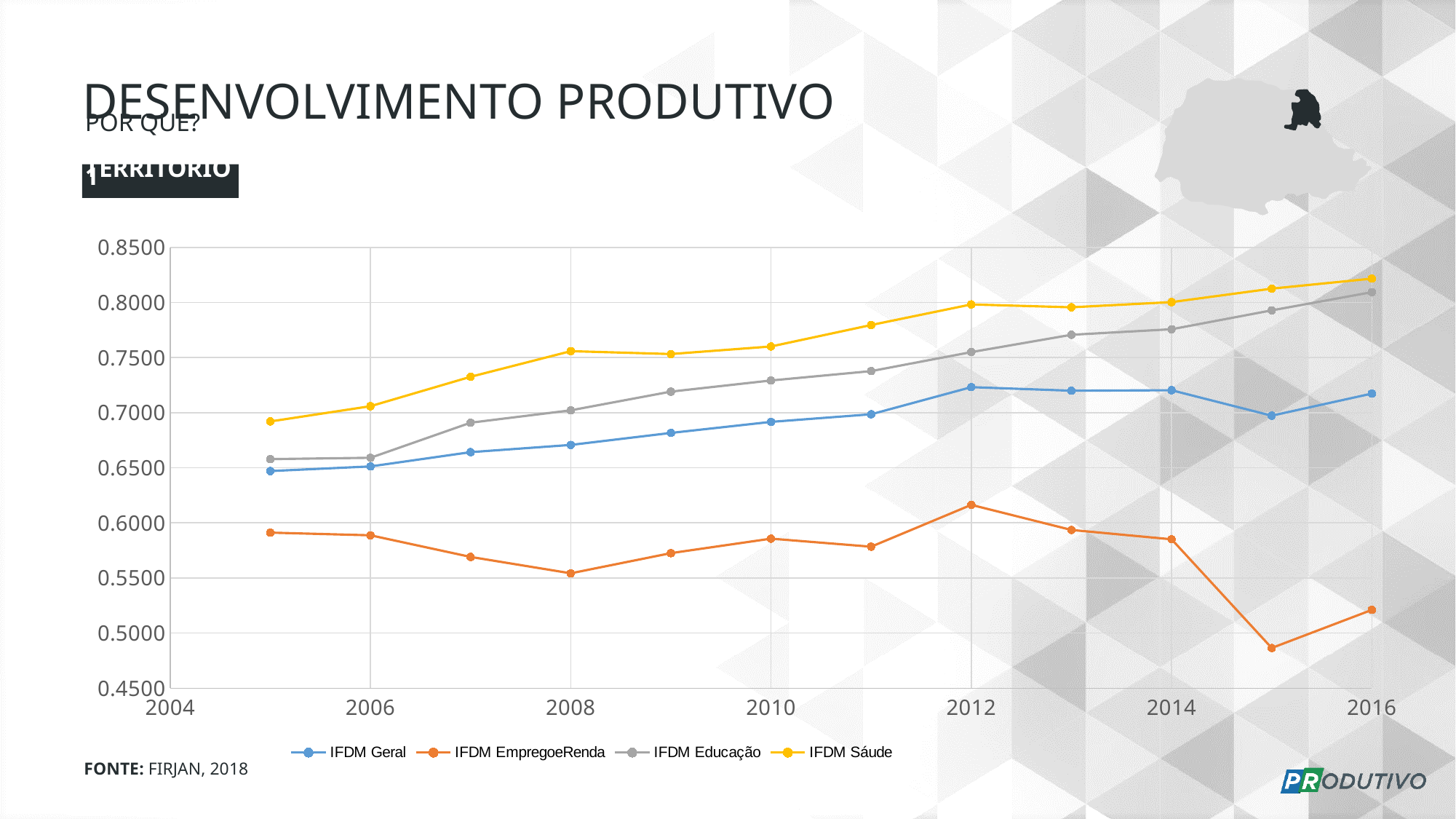
How many series does the legend list? 4 Which series has the lowest value in 2012? IFDM EmpregoeRenda Is the value for IFDM EmpregoeRenda in 2015 greater or less than 0.5000? less How many data points does the IFDM Saúde line have? 12 Is the value for IFDM Geral in 2012 greater or less than 0.7000? greater What kind of chart is shown on the slide? line chart Is the value for IFDM Saúde in 2016 greater or less than 0.8000? greater Which series has the highest value in 2016? IFDM Saúde Does the IFDM Saúde line rise or fall overall from 2005 to 2016? rise In 2016, which is larger: IFDM Educação or IFDM Geral? IFDM Educação In which year does IFDM EmpregoeRenda reach its lowest value? 2015